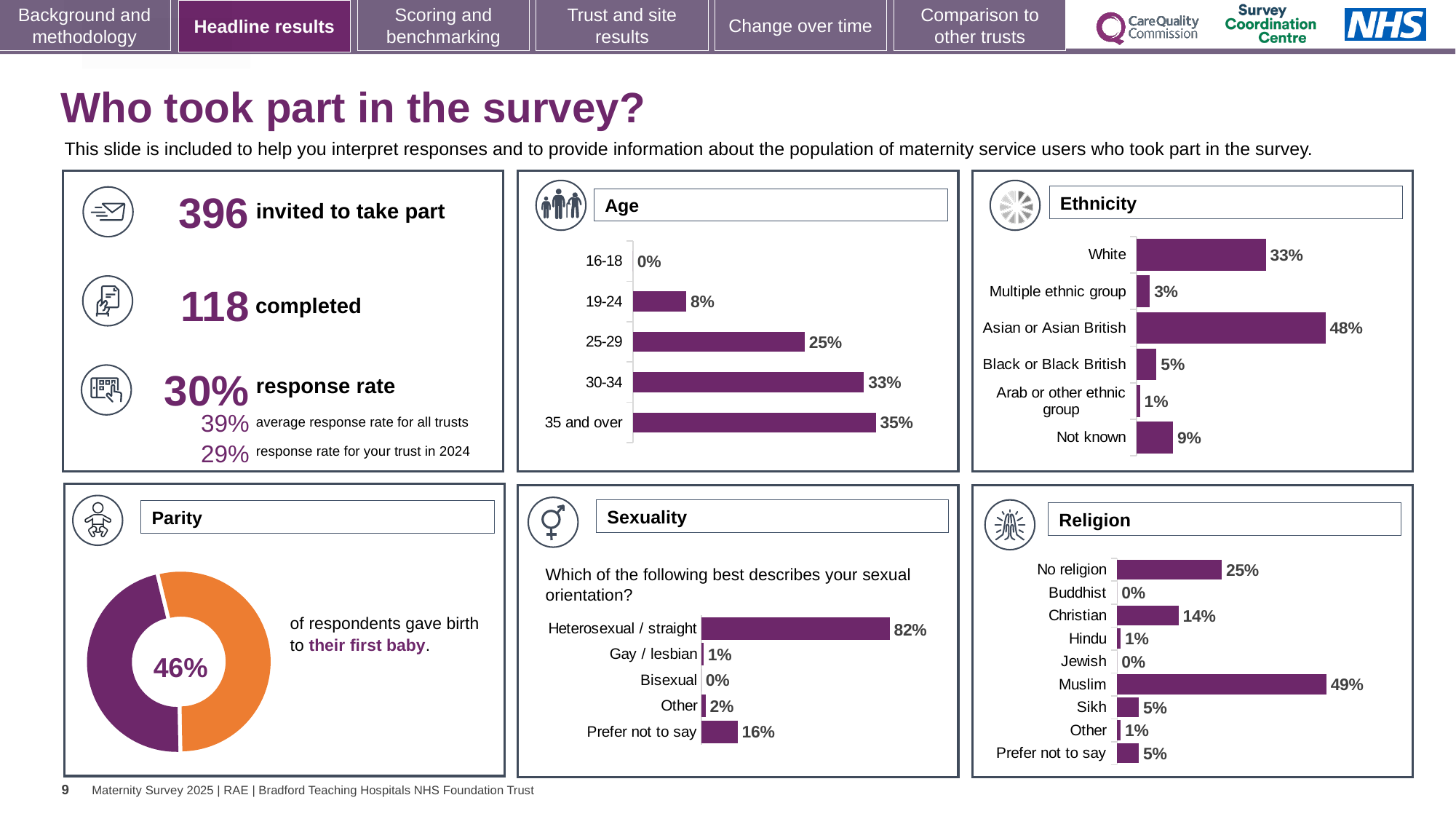
In the Religion chart, how many categories are listed? 9 In the Parity chart, what share of respondents gave birth to their first baby? 46% What kind of chart is used in the Parity panel? Doughnut chart In the Sexuality chart, which is larger: Other or Gay / lesbian? Other In the Religion chart, what is the value for Muslim? 49% In the Age chart, which age group has the highest percentage? 35 and over In the Sexuality chart, what percentage of respondents answered Prefer not to say? 16% In the Ethnicity chart, how many categories are shown? 6 In the Ethnicity chart, which category has the highest percentage? Asian or Asian British In the Ethnicity chart, what is the value for Asian or Asian British? 48% In the Ethnicity chart, what is the difference between the White and Not known percentages? 24% In the Age chart, what percentage of respondents were aged 30-34? 33%